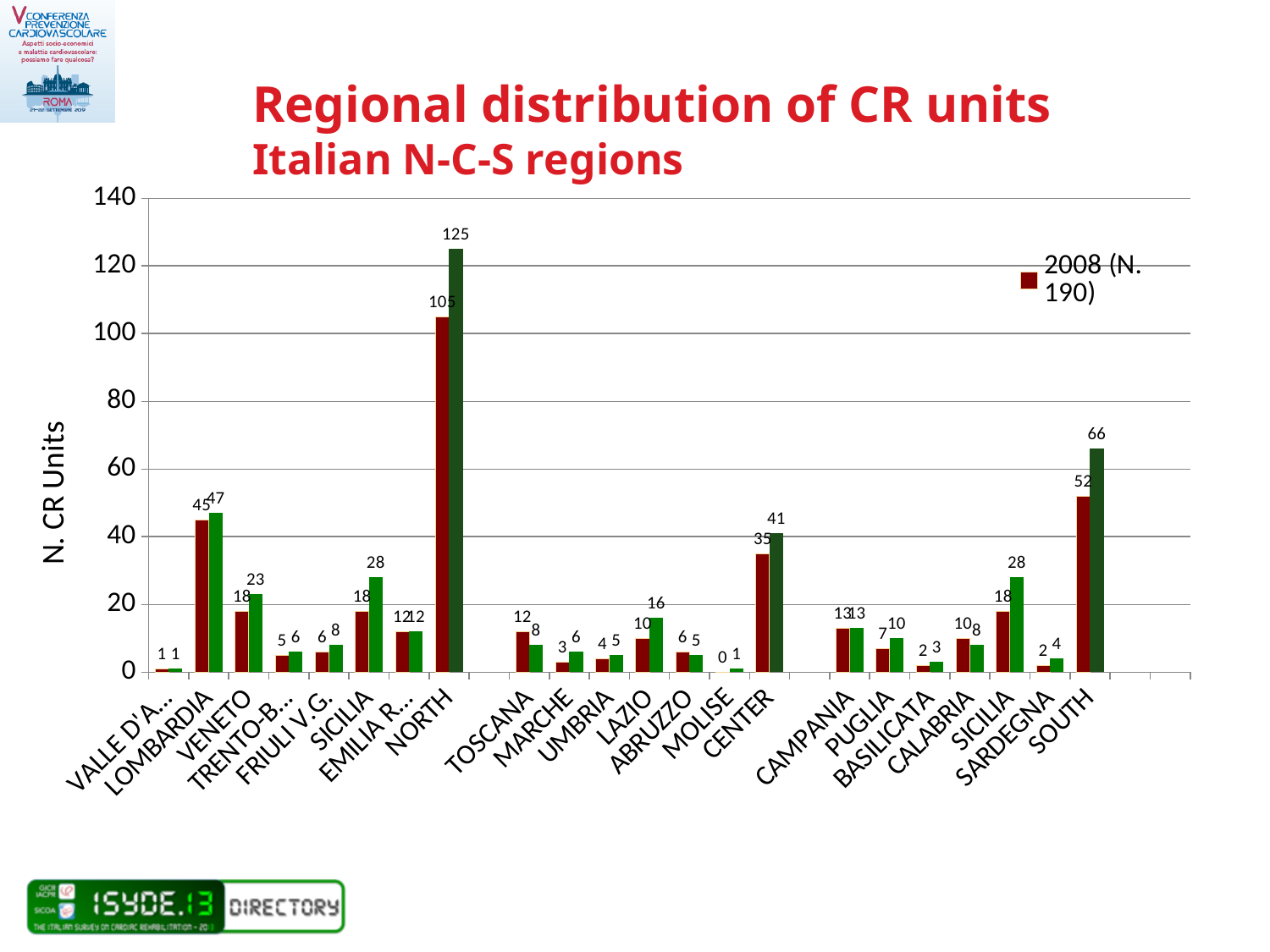
What is the 2008 (N. 190) value for MOLISE? 0 For TOSCANA, which is larger: the 2008 (N. 190) bar or the green bar? 2008 (N. 190) What is the 2008 (N. 190) value for NORTH? 105 What is the value of the green bar for LAZIO? 16 What is the 2008 (N. 190) value for CENTER? 35 What is the value of the green bar for NORTH? 125 What is the title of the vertical axis? N. CR Units What is the difference between the green bar and the 2008 (N. 190) bar for SOUTH? 14 How many categories are shown on the x axis? 22 What kind of chart is shown on the slide? bar chart What is the 2008 (N. 190) value for LOMBARDIA? 45 Which category has the highest 2008 (N. 190) value? NORTH